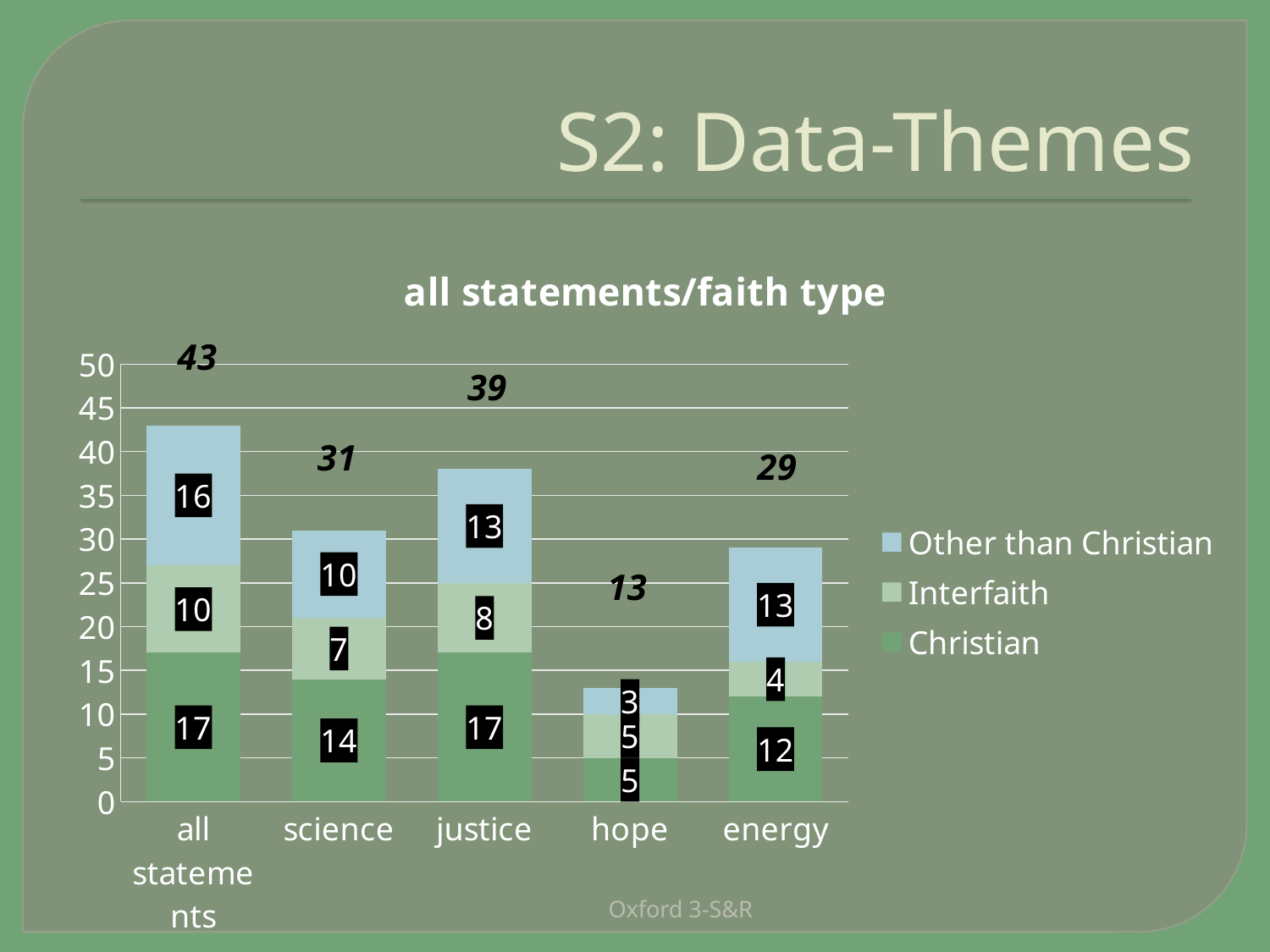
How many series does the legend list? 3 What is the Interfaith value for justice? 8 Which is larger, the Interfaith value for all statements or the Interfaith value for science? all statements Which category has the highest total stacked bar? all statements What is the Christian value for science? 14 What is the total of the stacked bar for energy? 29 Which category has the lowest total stacked bar? hope What is the difference between the Christian value for all statements and the Christian value for energy? 5 What is the title of the chart? all statements/faith type What is the Other than Christian value for energy? 13 How many categories are shown on the x axis? 5 What type of chart is shown on the slide? stacked bar chart